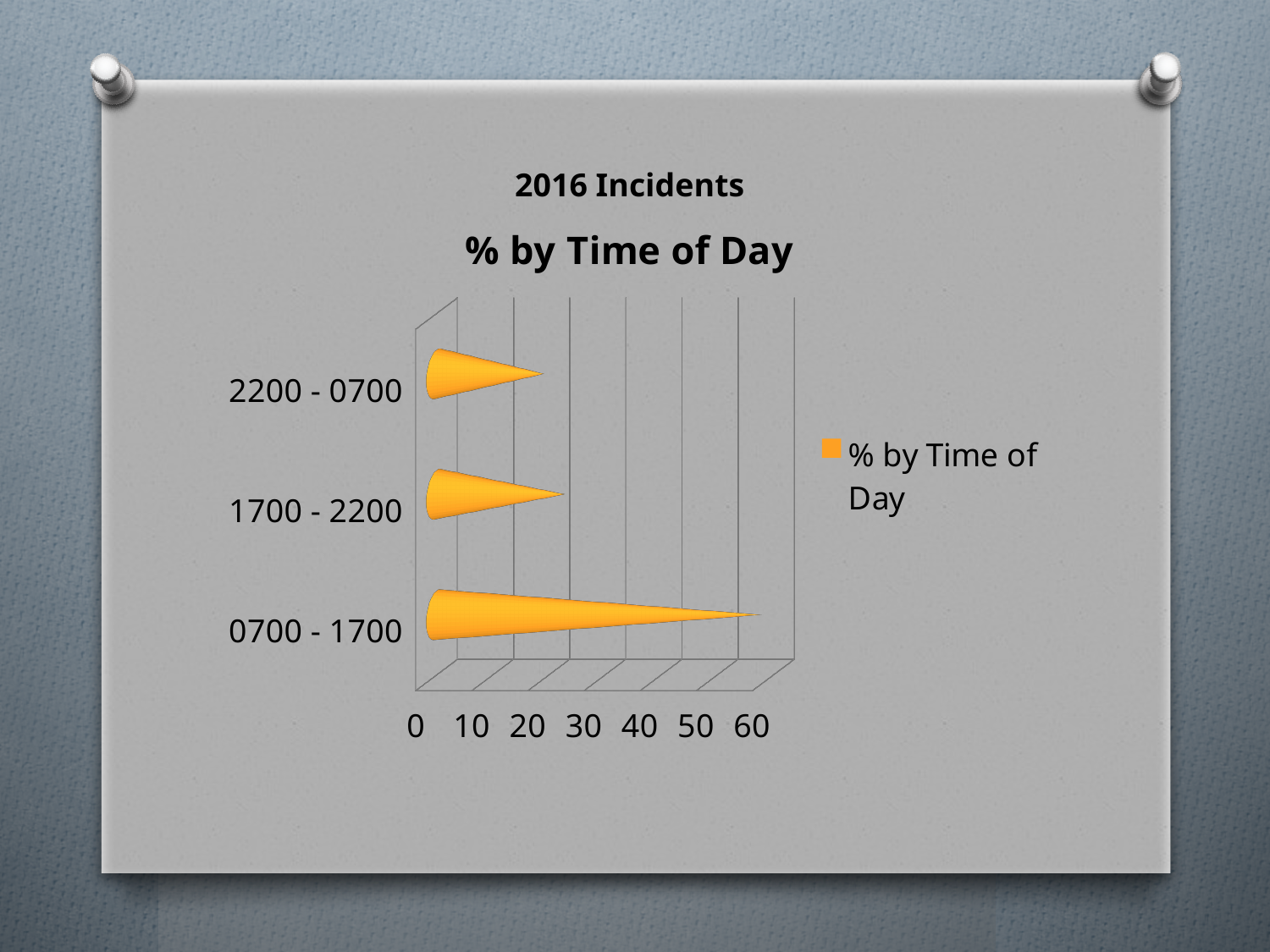
Is the value for 1700 - 2200 greater or less than 40? less Which time-of-day category has the lowest percentage of incidents? 2200 - 0700 How many time-of-day categories are plotted in the chart? 3 Is the value for 2200 - 0700 greater or less than 10? greater What is the name of the series shown in the chart legend? % by Time of Day Which time-of-day category has the highest percentage of incidents? 0700 - 1700 Is the value for 2200 - 0700 greater or less than 30? less How many series does the chart legend list? 1 What is the title of the chart? % by Time of Day What type of chart is shown on the slide? bar chart Which has a larger value, 0700 - 1700 or 1700 - 2200? 0700 - 1700